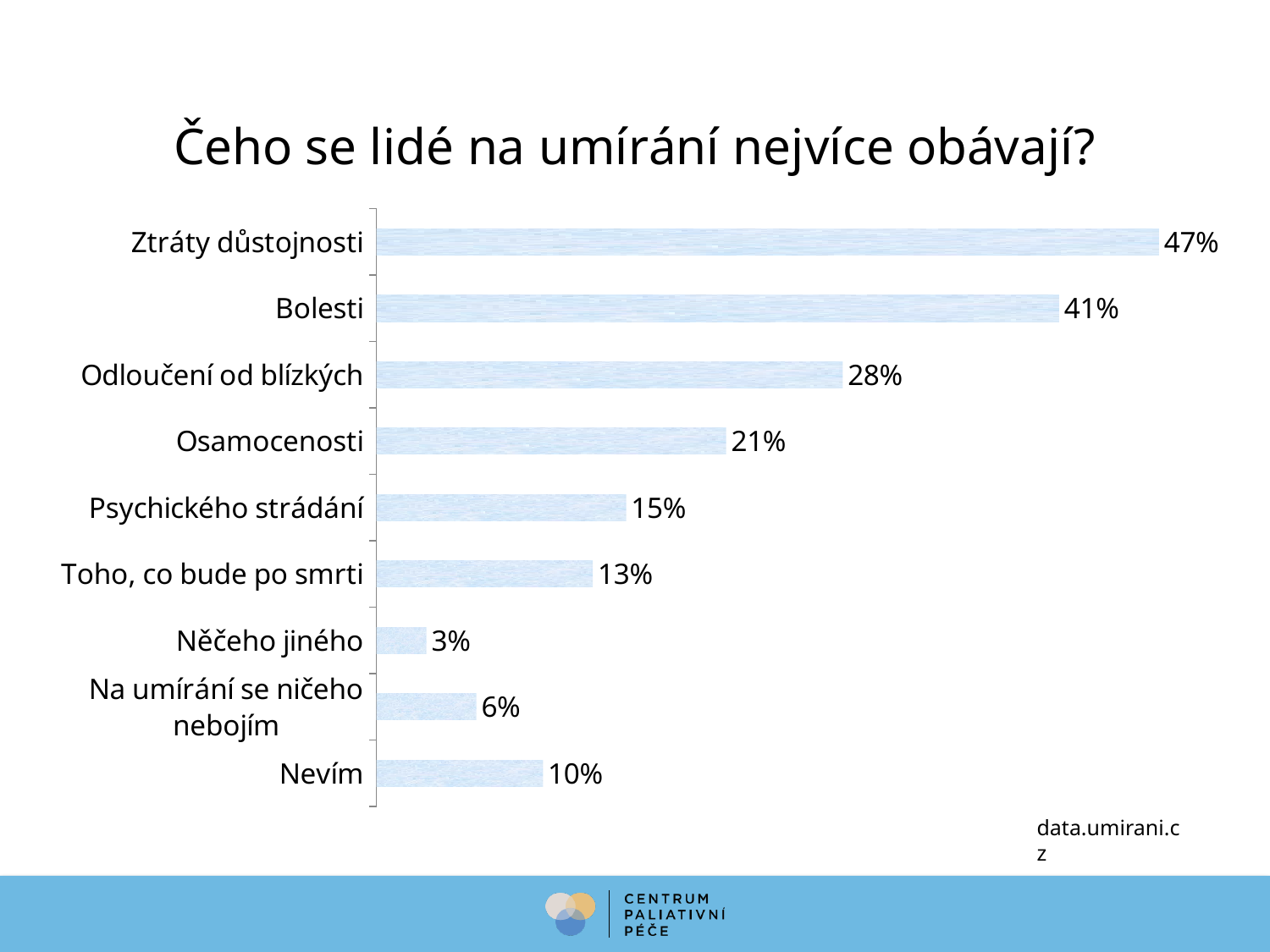
What is the value for Bolesti? 41% What is the difference between the values for Ztráty důstojnosti and Bolesti? 6% What is the title of the chart? Čeho se lidé na umírání nejvíce obávají? Which is larger, the value for Toho, co bude po smrti or the value for Nevím? Toho, co bude po smrti What is the value for Ztráty důstojnosti? 47% What is the value for Nevím? 10% What is the difference between the values for Osamocenosti and Psychického strádání? 6% How many categories are shown in the chart? 9 What kind of chart is shown on the slide? Bar chart What is the value for Odloučení od blízkých? 28% Which category has the lowest value? Něčeho jiného Which category has the highest value? Ztráty důstojnosti